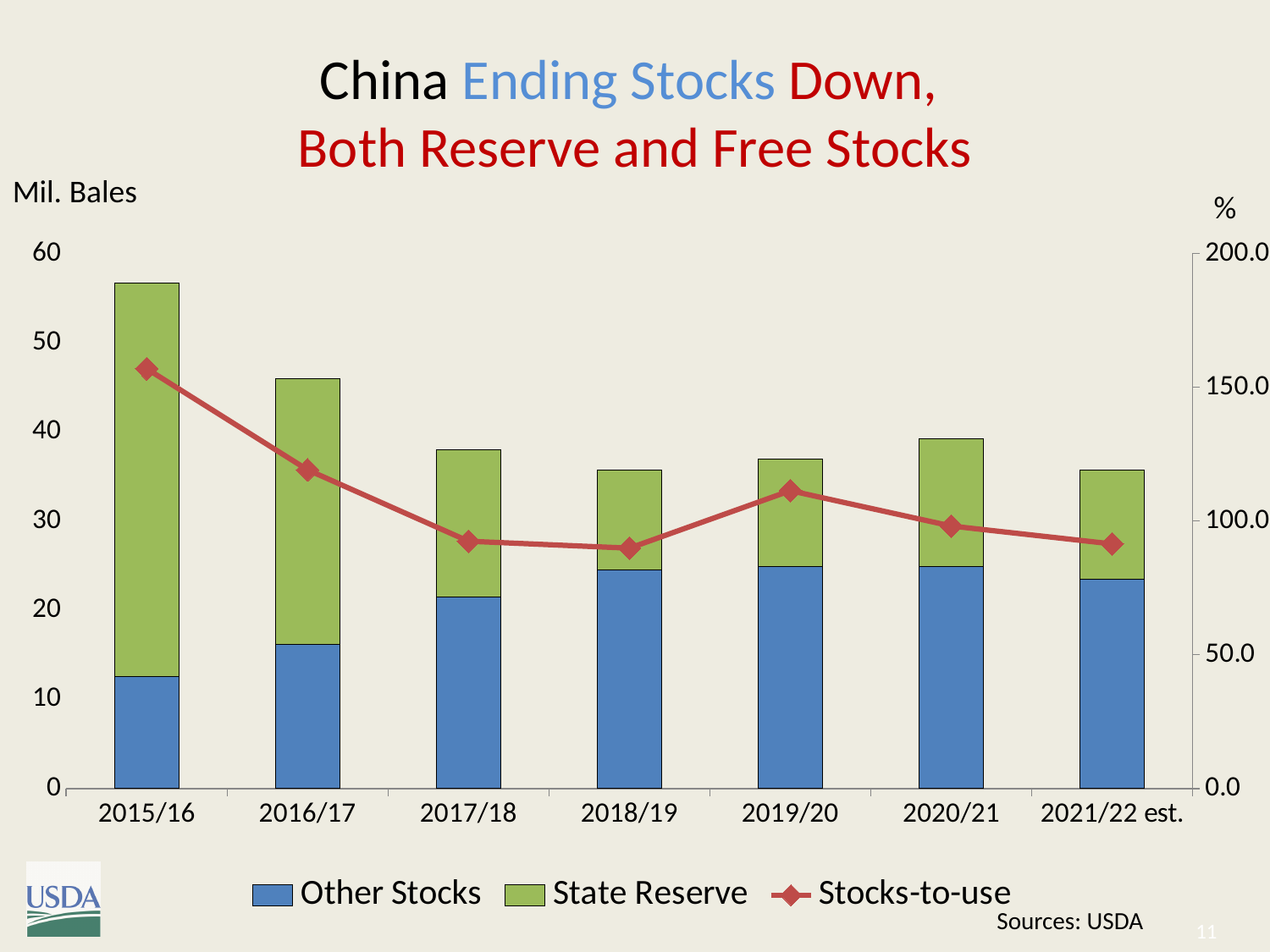
What unit is shown on the left vertical axis? Mil. Bales Which is larger, the State Reserve for 2015/16 or for 2016/17? 2015/16 How many series does the legend list? 3 Is the Stocks-to-use value for 2016/17 greater or less than 100.0%? greater Which year has the highest total ending stocks (tallest stacked bar)? 2015/16 Is the Stocks-to-use value for 2018/19 greater or less than 100.0%? less Does the Stocks-to-use line rise or fall from 2015/16 to 2018/19? Falls How many marketing years are shown on the x axis? 7 What kind of chart is shown on the slide? A stacked bar chart with a line Is the total stacked bar for 2015/16 greater or less than 50 Mil. Bales? greater Which year has the highest Stocks-to-use value? 2015/16 Which year has the lowest Other Stocks value? 2015/16